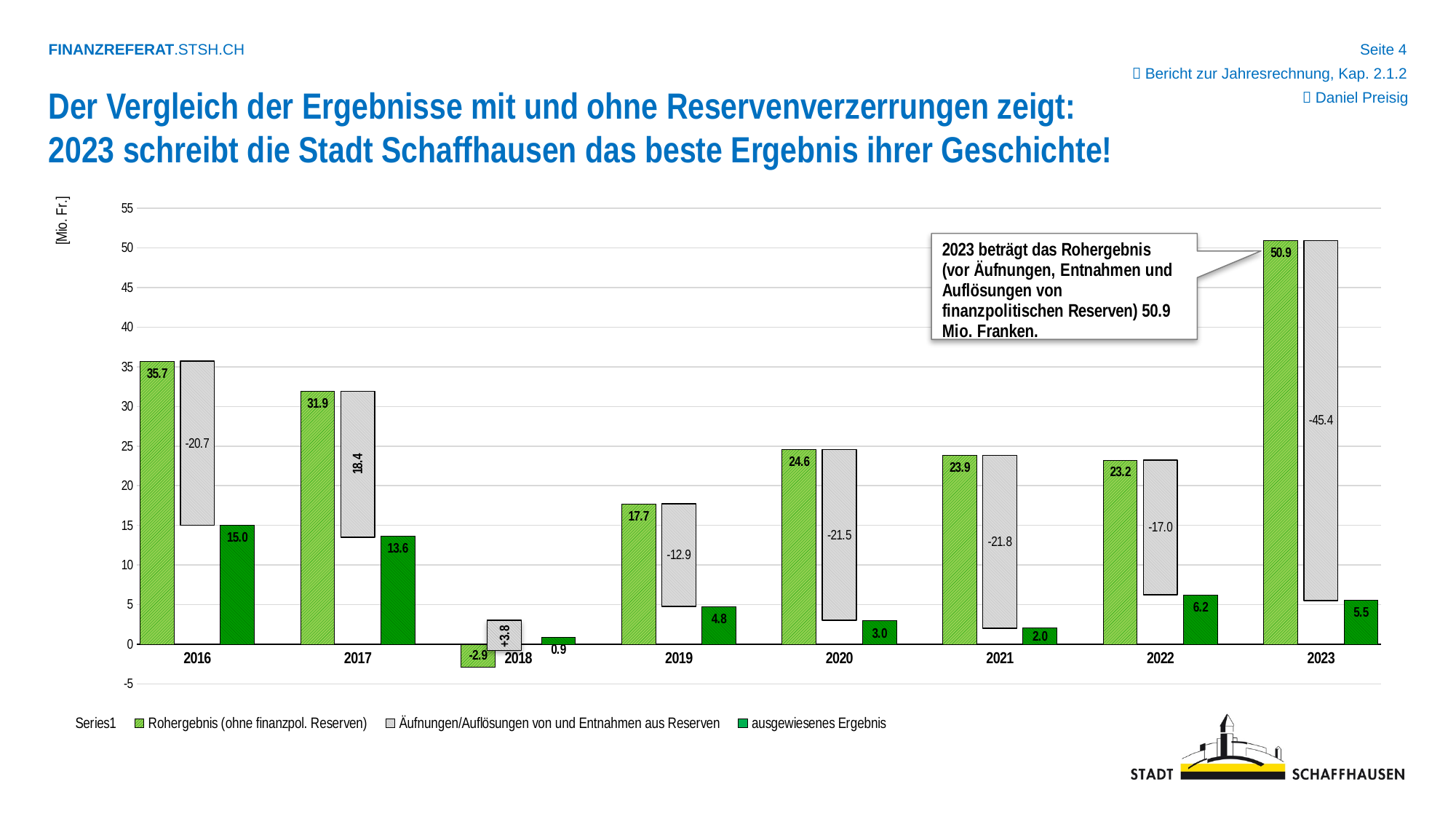
Which year has the highest Rohergebnis (ohne finanzpol. Reserven)? 2023 What is the ausgewiesenes Ergebnis value for 2016? 15.0 What unit is shown on the y axis of the chart? [Mio. Fr.] What is the Äufnungen/Auflösungen von und Entnahmen aus Reserven value for 2020? -21.5 What is the difference between the Rohergebnis (ohne finanzpol. Reserven) for 2023 and for 2016? 15.2 Which is larger, the ausgewiesenes Ergebnis for 2022 or for 2023? 2022 Which year has the lowest ausgewiesenes Ergebnis? 2018 What is the Rohergebnis (ohne finanzpol. Reserven) value for 2018? -2.9 What kind of chart is shown on the slide? bar chart Is the Rohergebnis (ohne finanzpol. Reserven) for 2019 greater or less than 20? less How many years are shown on the x axis of the chart? 8 What is the Rohergebnis (ohne finanzpol. Reserven) value for 2023? 50.9